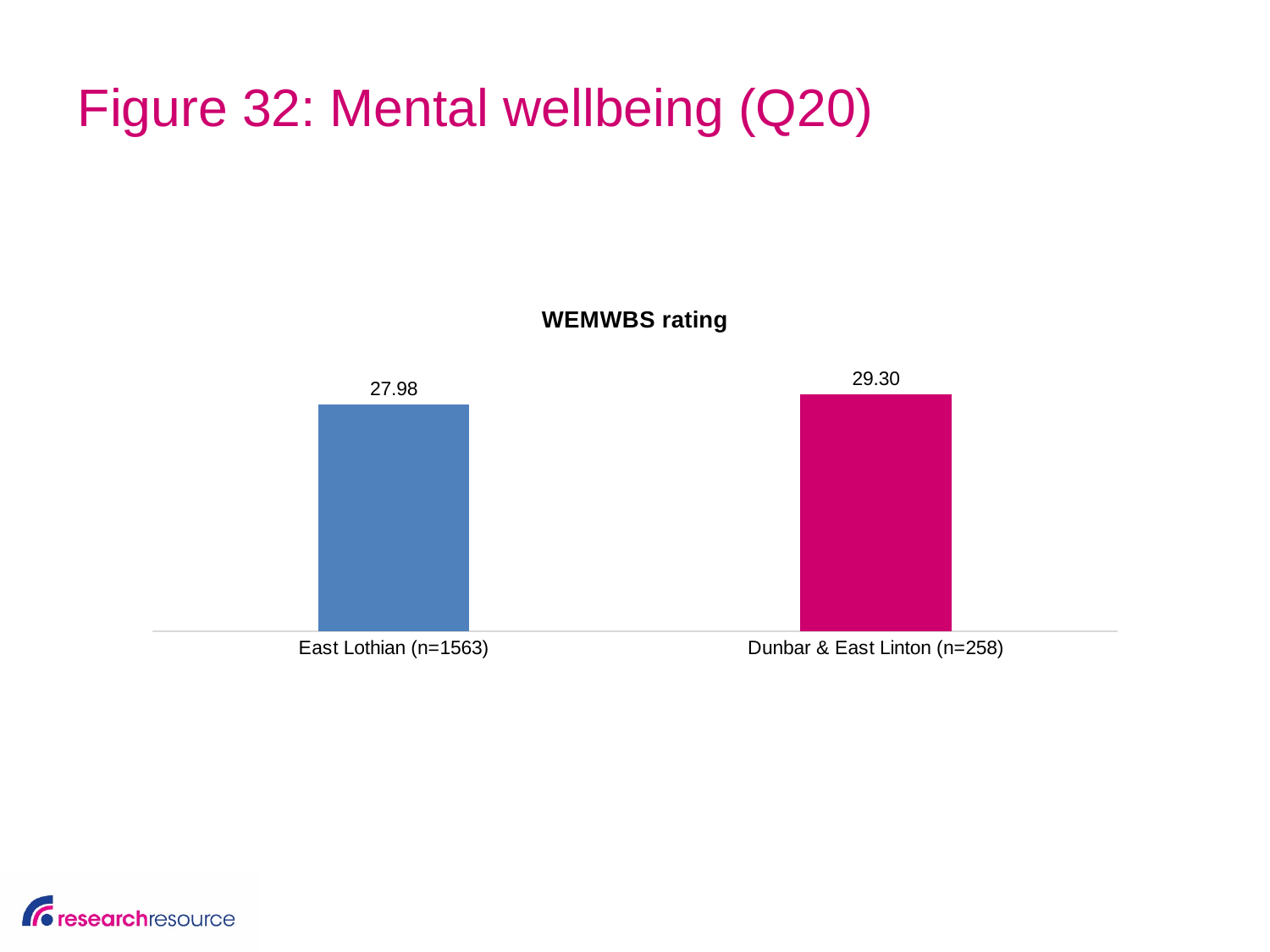
What is the sample size shown for East Lothian? n=1563 What colour is the bar for Dunbar & East Linton (n=258)? pink/magenta Which category has the higher WEMWBS rating? Dunbar & East Linton (n=258) What is the sample size shown for Dunbar & East Linton? n=258 How many categories are shown in the chart? 2 What is the difference between the WEMWBS ratings for Dunbar & East Linton and East Lothian? 1.32 What is the WEMWBS rating for Dunbar & East Linton (n=258)? 29.30 What is the title of the chart? WEMWBS rating Which category has the lower WEMWBS rating? East Lothian (n=1563) What kind of chart is shown on the slide? bar chart What is the WEMWBS rating for East Lothian (n=1563)? 27.98 Is the WEMWBS rating for East Lothian larger or smaller than that for Dunbar & East Linton? smaller